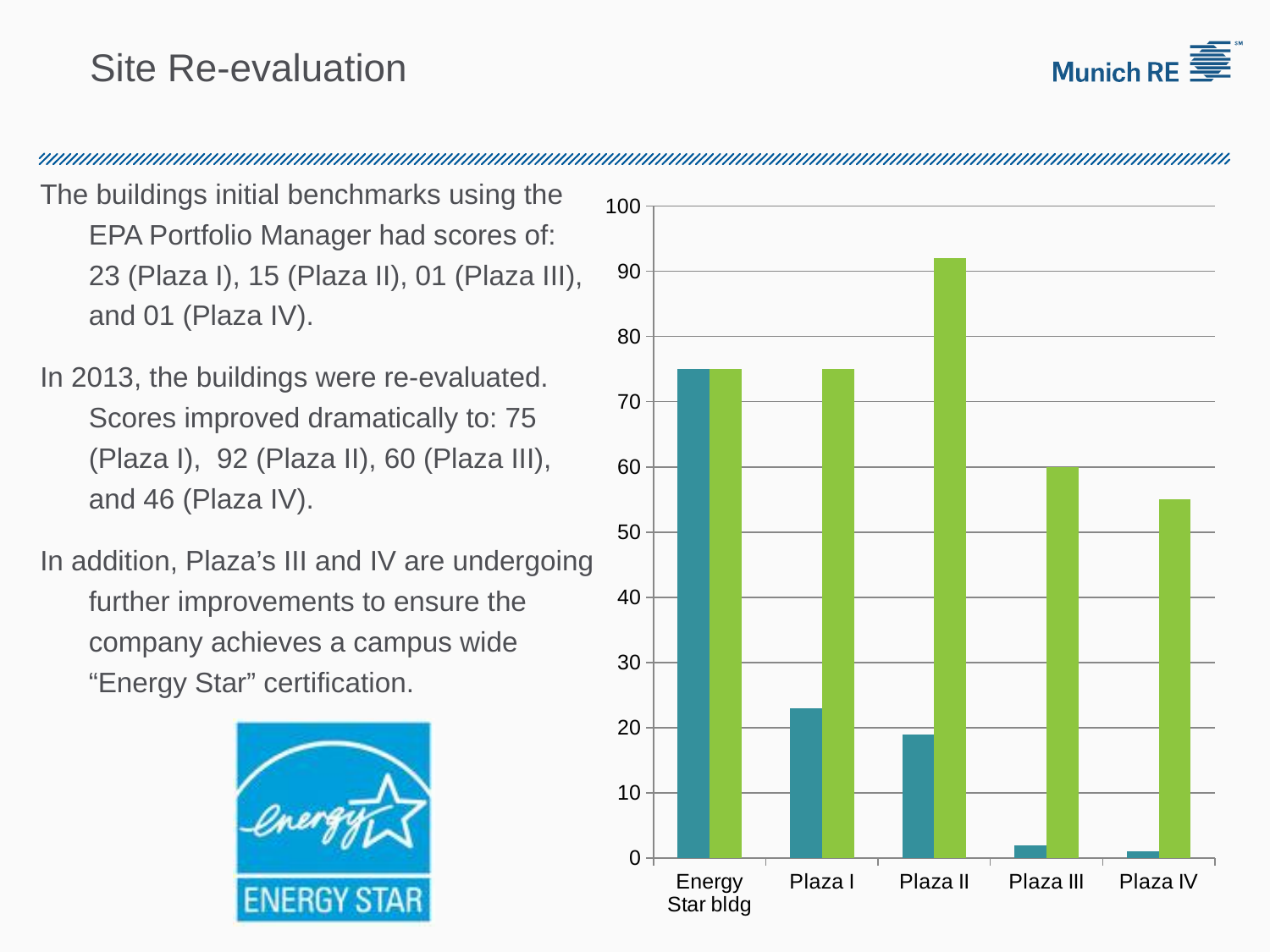
What is the highest value shown on the y axis of the chart? 100 How many bars are plotted for each category in the chart? 2 Is the dark teal bar for Plaza I greater or less than 20? greater Is the dark teal bar for Plaza III greater or less than 10? less What is the value of the green bar for Plaza III? 60 Is the green bar for Plaza IV greater or less than 50? greater How many categories are shown on the x axis of the chart? 5 What kind of chart is shown on the slide? bar chart Which category has the tallest bar in the chart? Plaza II Which category has the shortest bar in the chart? Plaza IV Which is larger, the green bar for Plaza II or the green bar for Plaza I? Plaza II